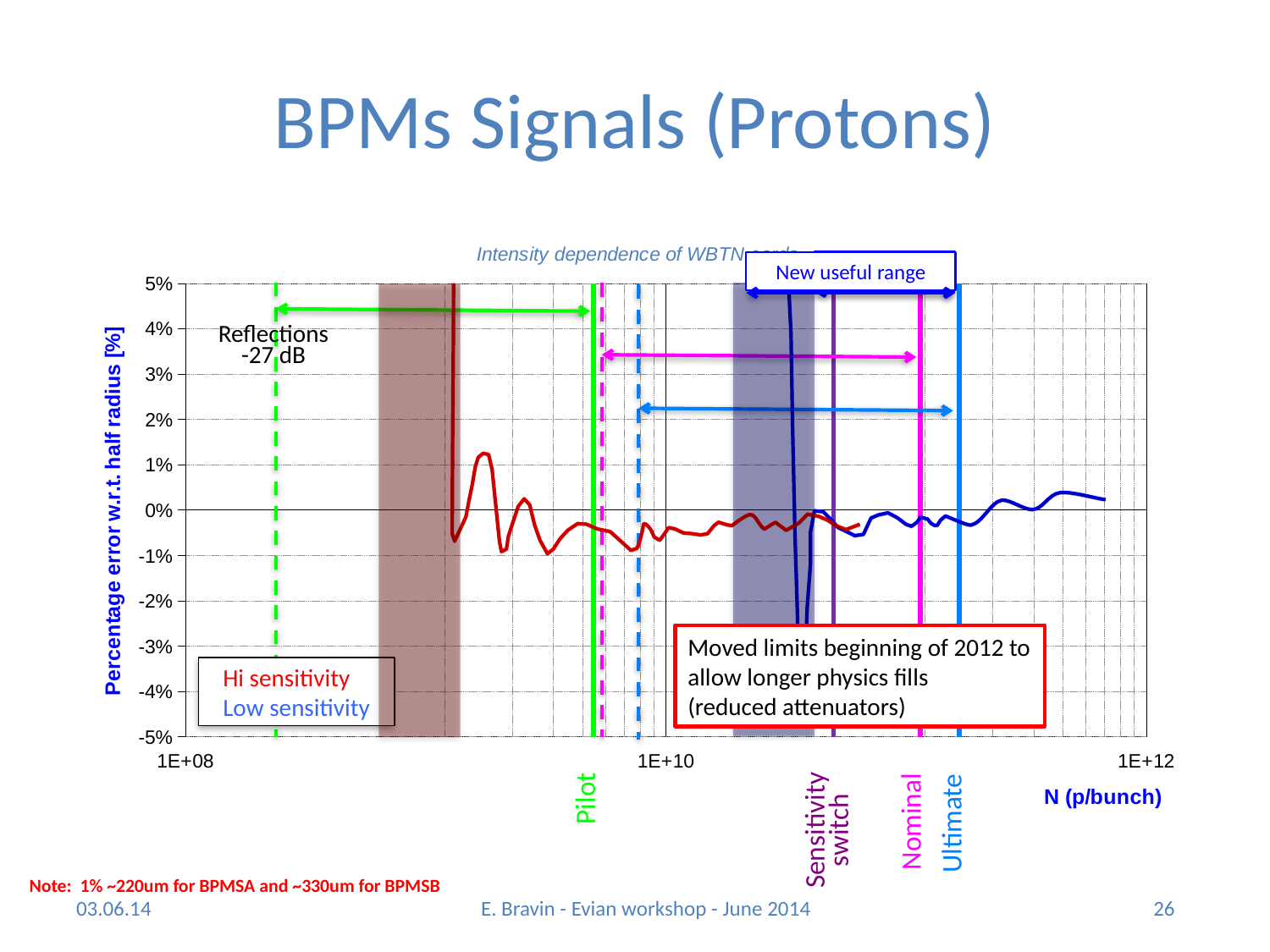
Is the Hi sensitivity value at 1E+10 p/bunch greater or less than 1%? less Which series is drawn in red on the chart? Hi sensitivity Is the Low sensitivity value at 1E+11 p/bunch greater or less than -2%? greater What is the label of the chart's y axis? Percentage error w.r.t. half radius [%] Is the Hi sensitivity value at 1E+10 p/bunch greater or less than -2%? greater What kind of chart is shown on the slide? line chart